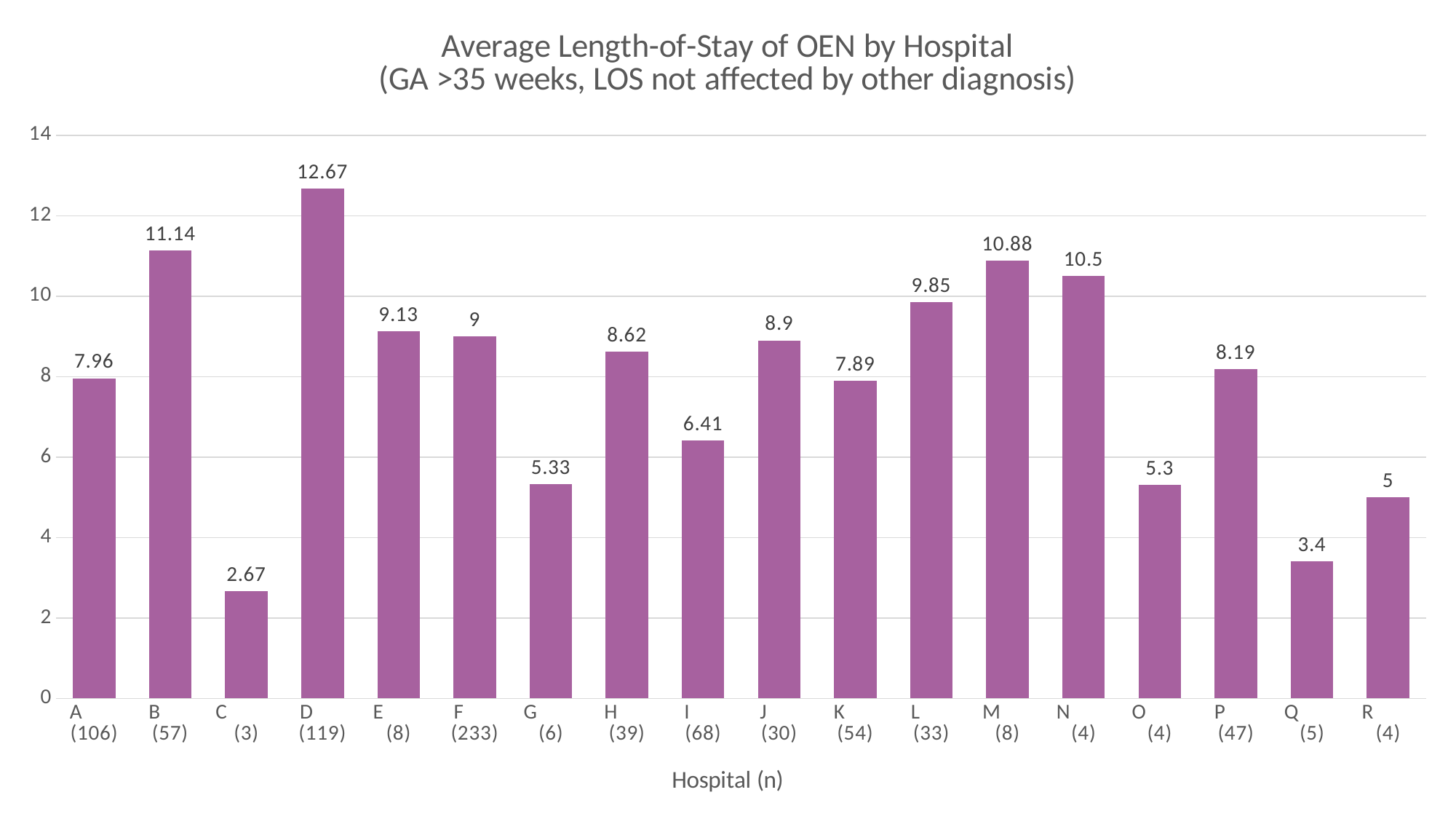
Is the value for Hospital I greater or less than 8? less What is the sample size (n) shown for Hospital F? 233 Which has a higher average length-of-stay, Hospital M or Hospital N? M What is the average length-of-stay for Hospital Q? 3.4 What is the average length-of-stay for Hospital D? 12.67 What is the label of the x axis? Hospital (n) Which hospital has the highest average length-of-stay? D What is the difference between the average length-of-stay of Hospital B and Hospital A? 3.18 Which hospital has the lowest average length-of-stay? C What kind of chart is shown on the slide? Bar chart How many hospitals are shown on the chart? 18 What is the average length-of-stay for Hospital L? 9.85